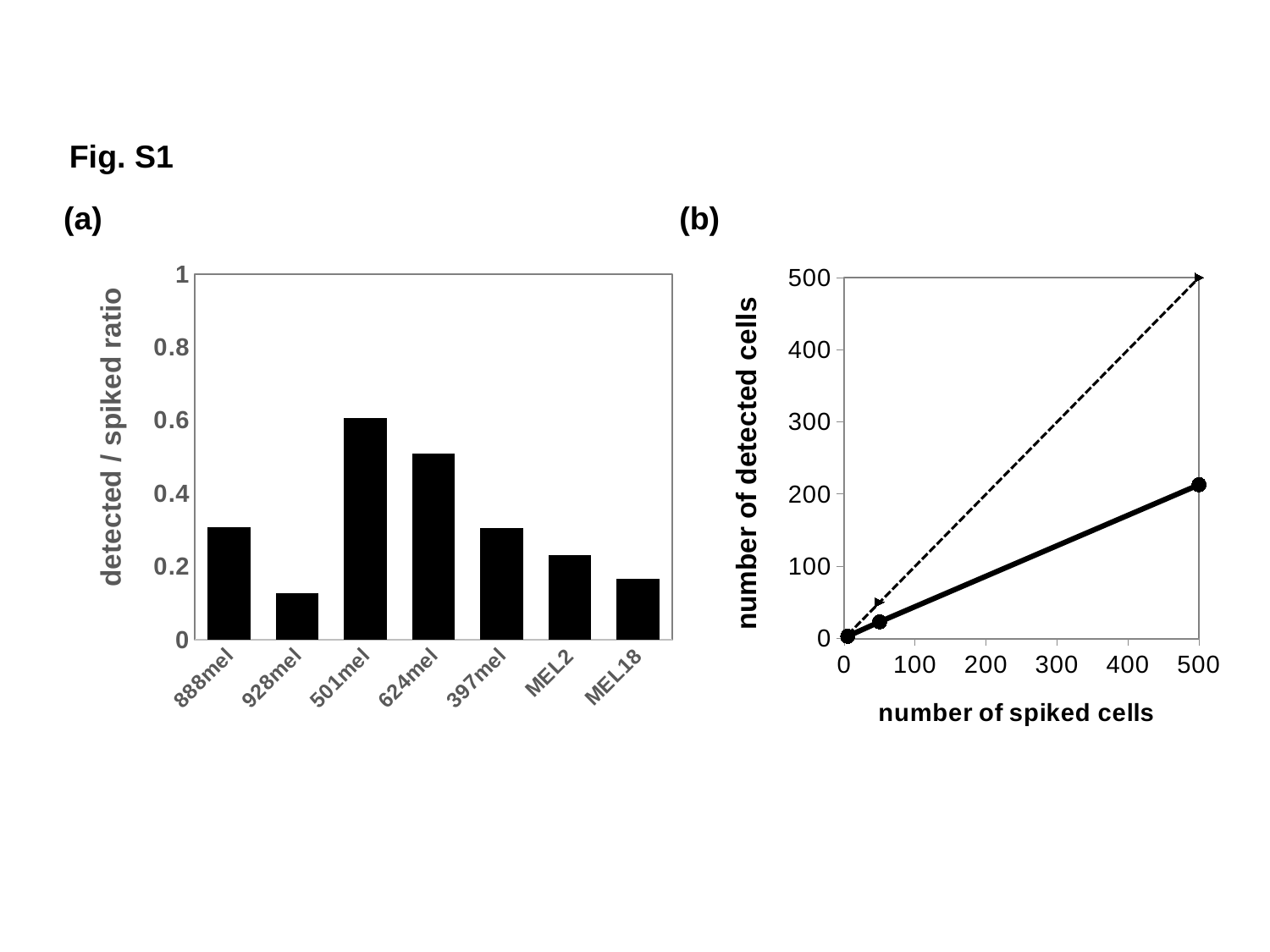
In chart (a), what is the label of the y axis? detected / spiked ratio In chart (a), is the value for 501mel greater or less than 0.4? greater In chart (b), what kind of chart is shown? line chart In chart (b), is the number of detected cells on the solid line at 500 spiked cells greater or less than 300? less In chart (a), is the value for MEL18 greater or less than 0.2? less In chart (a), which has the larger detected / spiked ratio, 501mel or 624mel? 501mel In chart (a), what kind of chart is shown? bar chart In chart (a), which cell line has the highest detected / spiked ratio? 501mel In chart (a), how many cell lines are shown on the x axis? 7 In chart (a), which cell line has the lowest detected / spiked ratio? 928mel In chart (b), does the number of detected cells rise or fall as the number of spiked cells increases? rise